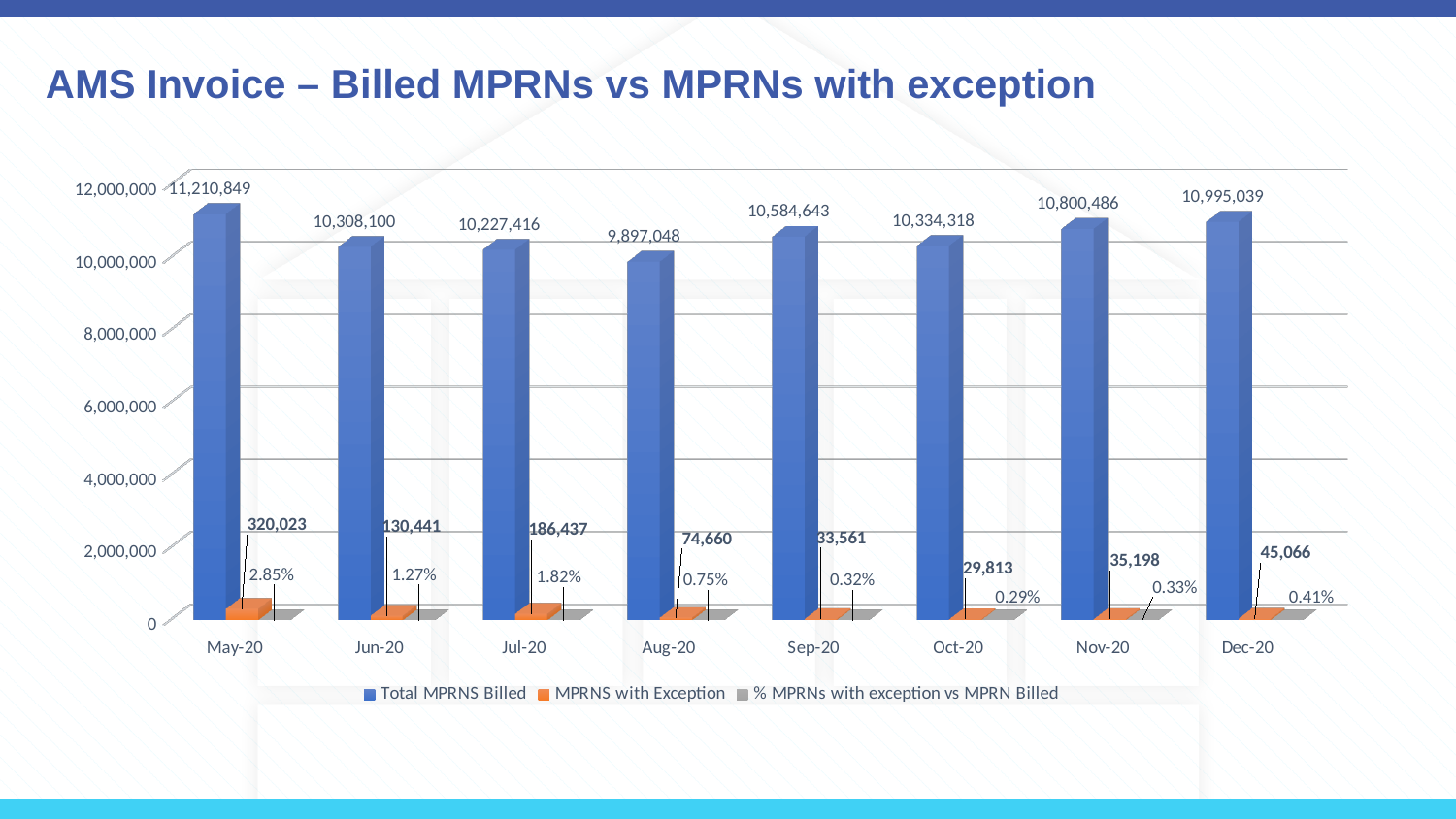
Which month has the highest MPRNS with Exception? May-20 What kind of chart is shown on the slide? bar chart What is the Total MPRNS Billed value for May-20? 11,210,849 How many months are shown on the x axis? 8 Does the % MPRNs with exception vs MPRN Billed rise or fall from May-20 to Sep-20? fall What is the MPRNS with Exception value for Jul-20? 186,437 Is the Total MPRNS Billed for Aug-20 greater or less than 10,000,000? less Which month has the lowest Total MPRNS Billed? Aug-20 What is the % MPRNs with exception vs MPRN Billed for Oct-20? 0.29% How many series does the legend list? 3 Which is larger, the MPRNS with Exception for Jun-20 or for Aug-20? Jun-20 What is the difference in Total MPRNS Billed between Dec-20 and Nov-20? 194,553